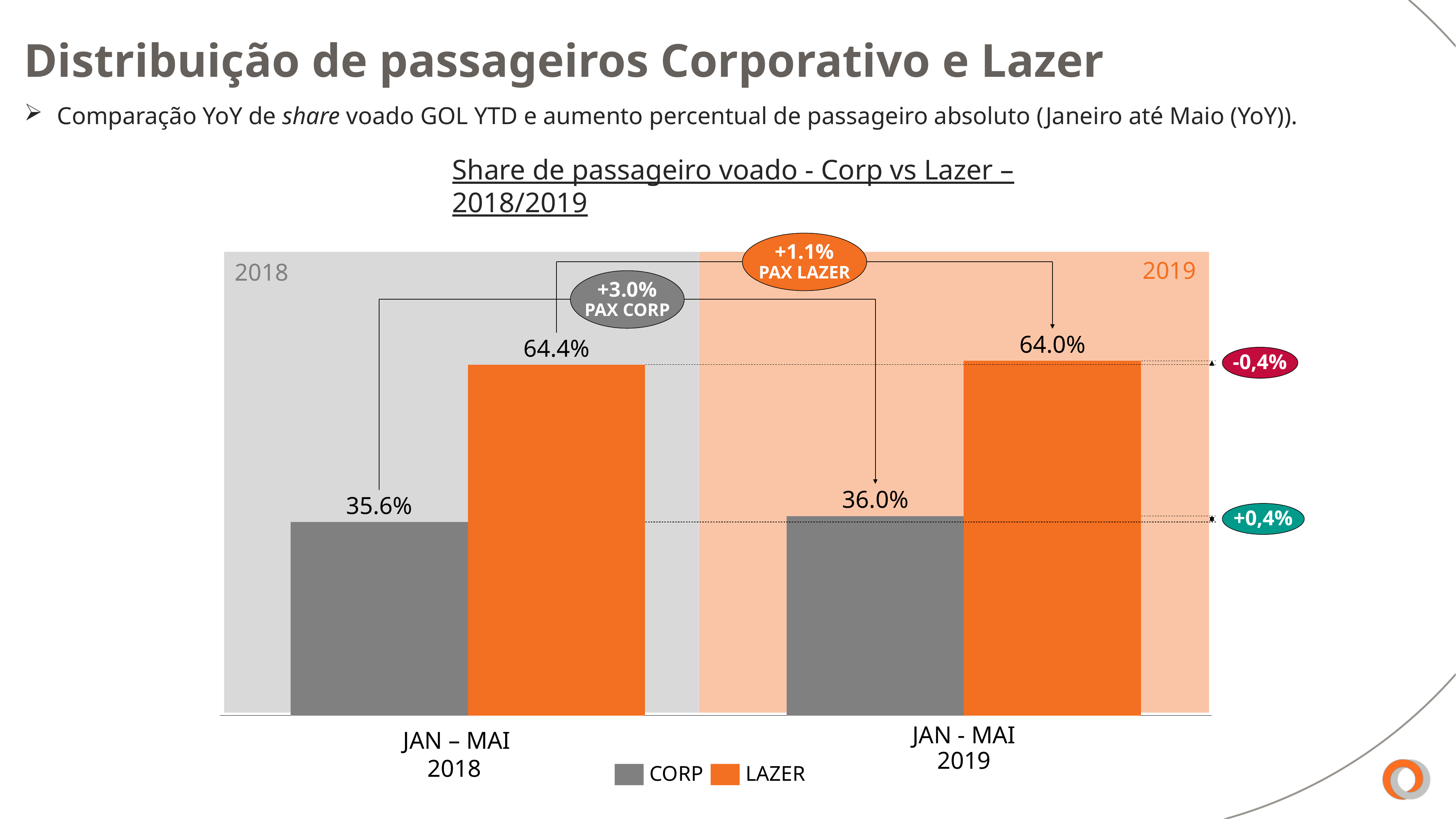
What is the difference between the LAZER and CORP shares in JAN – MAI 2018? 28.8% What is the CORP share for JAN – MAI 2018? 35.6% Which series has the lowest share in JAN – MAI 2018? CORP What colour represents the LAZER series in the chart? orange What is the LAZER share for JAN – MAI 2018? 64.4% How many categories are shown on the x axis? 2 What kind of chart is shown on the slide? bar chart Is the CORP share in JAN - MAI 2019 larger or smaller than the CORP share in JAN – MAI 2018? larger What is the LAZER share for JAN - MAI 2019? 64.0% How many series does the legend list? 2 Which series has the highest share in JAN - MAI 2019? LAZER What is the CORP share for JAN - MAI 2019? 36.0%